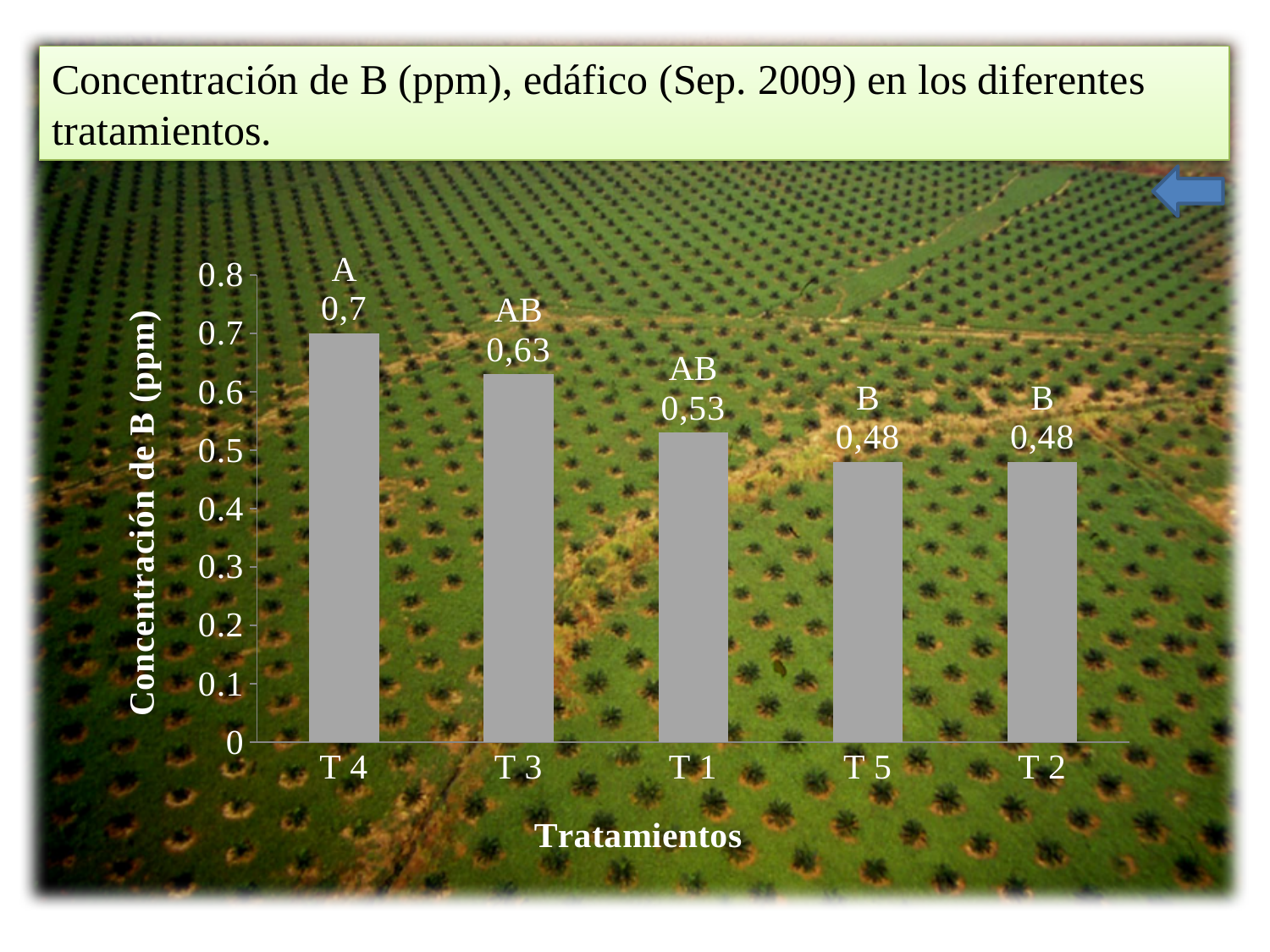
What is the value for T 5? 0,48 What is the difference between the values for T 4 and T 3? 0,07 What is the label of the y axis? Concentración de B (ppm) What is the difference between the values for T 1 and T 2? 0,05 Which is larger, the value for T 3 or the value for T 1? T 3 What is the value for T 3? 0,63 How many treatments are shown on the x axis? 5 What is the value for T 4? 0,7 Is the value for T 1 greater or less than 0.5? greater Which treatment has the highest concentration of B? T 4 What is the value for T 1? 0,53 What kind of chart is shown on the slide? bar chart